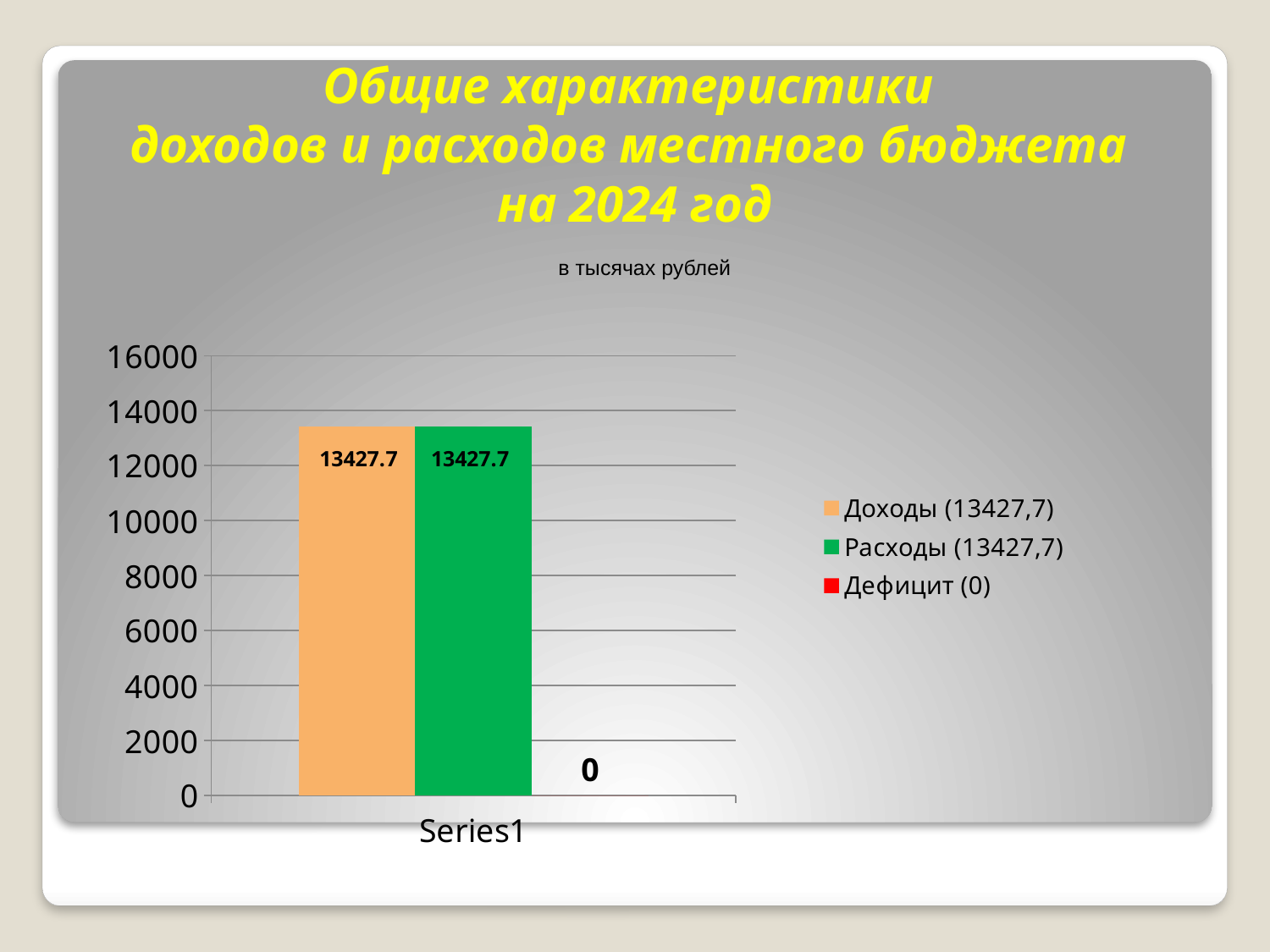
What is the value shown for Расходы? 13427.7 How many series does the legend list? 3 Which series has the lowest value? Дефицит What is the difference between the values for Доходы and Дефицит? 13427.7 Which is larger, the value for Расходы or the value for Дефицит? Расходы What kind of chart is shown on the slide? bar chart What is the value shown for Доходы? 13427.7 What is the value shown for Дефицит? 0 What unit is stated above the chart? в тысячах рублей Is the value for Расходы greater or less than 14000? less What is the difference between the values for Доходы and Расходы? 0 Is the value for Доходы greater or less than 12000? greater